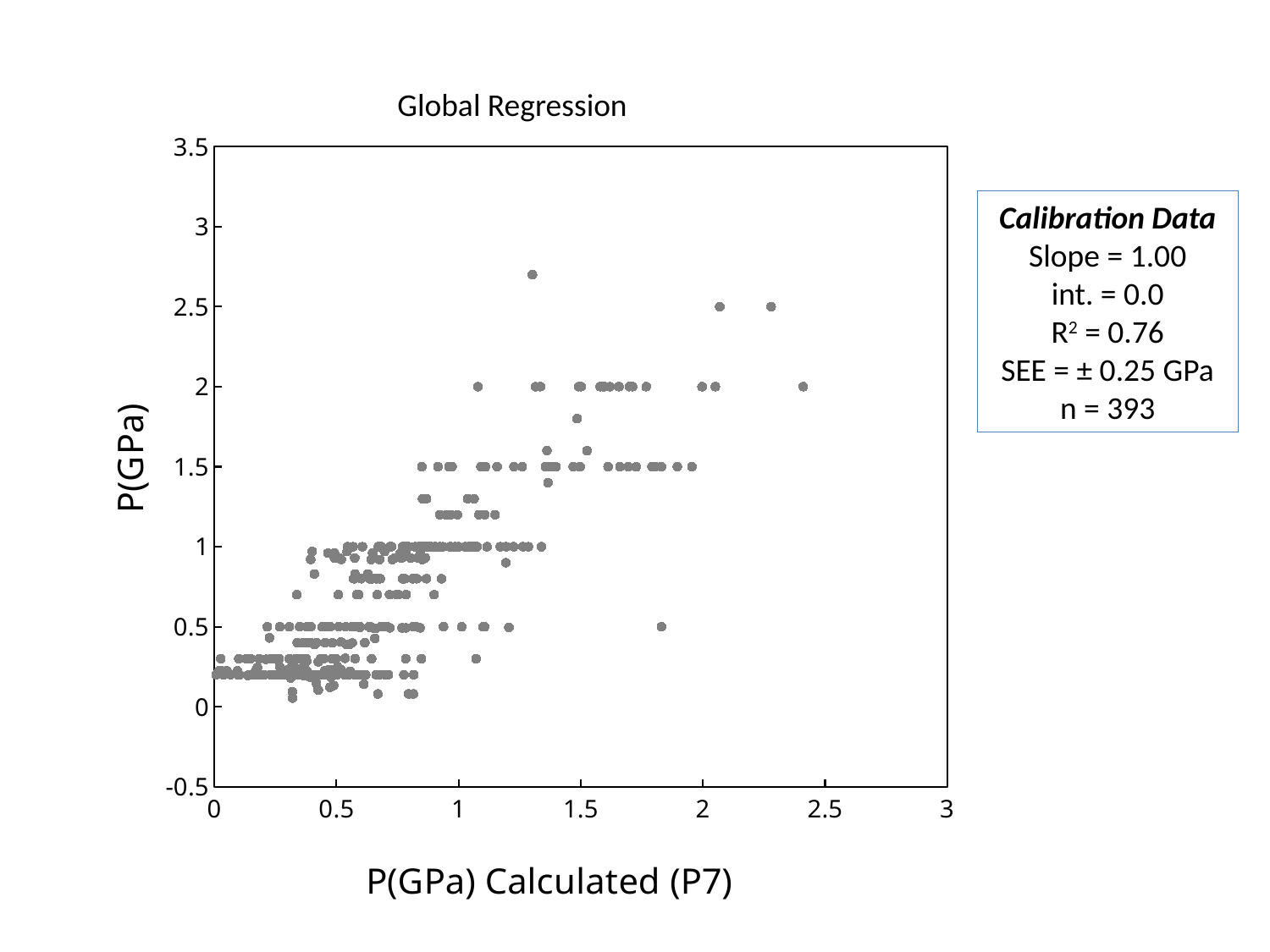
What kind of chart is shown on the slide? Scatter plot Is the largest x-axis value among the plotted points greater or less than 2? greater According to the Calibration Data box, how many data points (n) are in the regression? 393 Is the lowest plotted P(GPa) value greater or less than 0.5? less Is the highest plotted P(GPa) value greater or less than 2.5? greater What is the maximum value shown on the y axis? 3.5 According to the Calibration Data box, what is the R² value? 0.76 What is the minimum value shown on the y axis? -0.5 Do the plotted P(GPa) values generally rise or fall as P(GPa) Calculated (P7) increases along the x axis? Rise